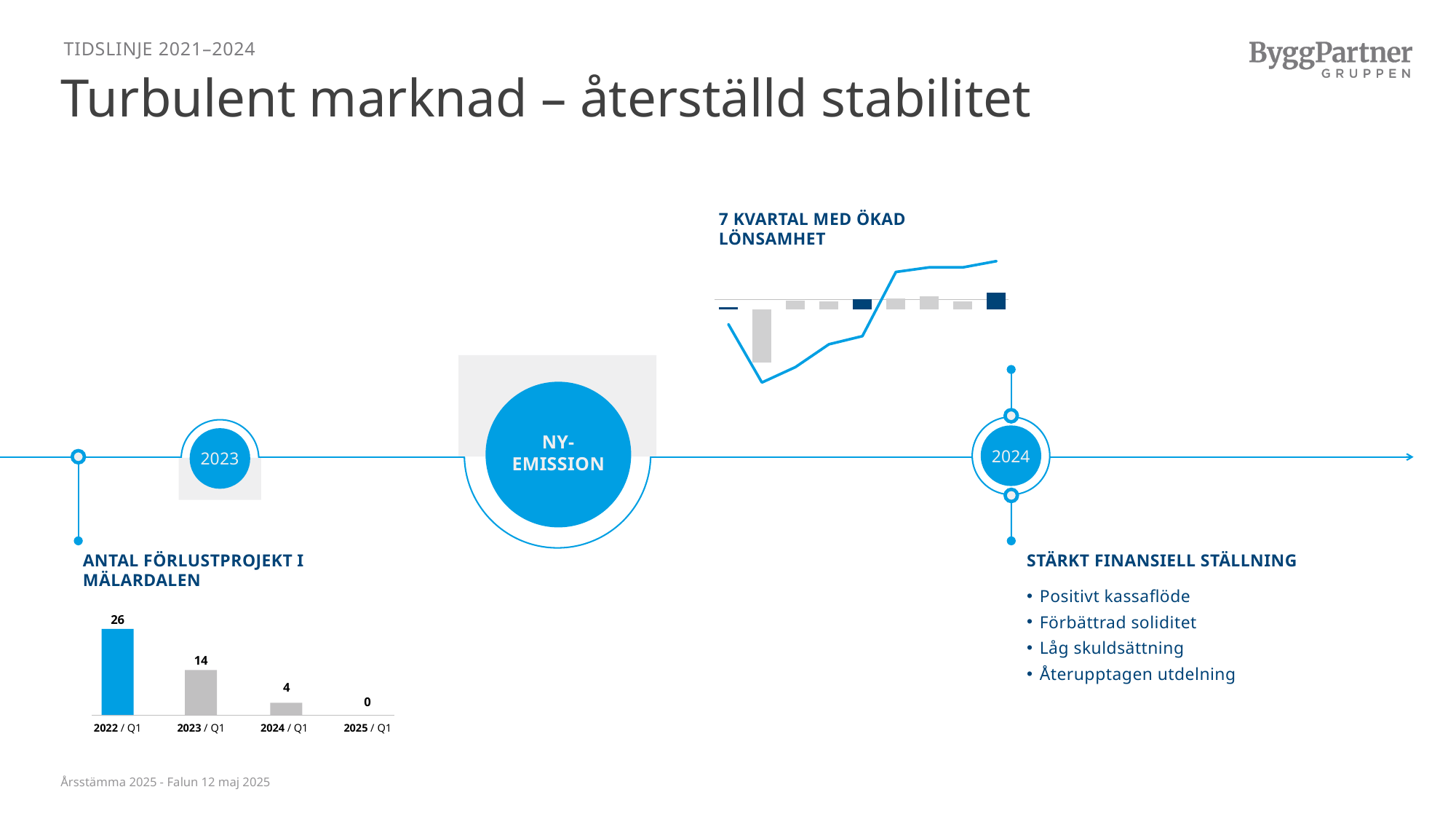
What kind of chart is 'ANTAL FÖRLUSTPROJEKT I MÄLARDALEN'? Bar chart In the chart '7 KVARTAL MED ÖKAD LÖNSAMHET', does the line rise or fall overall from left to right? Rise In the chart 'ANTAL FÖRLUSTPROJEKT I MÄLARDALEN', what is the value for 2024 / Q1? 4 In the chart 'ANTAL FÖRLUSTPROJEKT I MÄLARDALEN', which is larger, the value for 2023 / Q1 or 2024 / Q1? 2023 / Q1 How many periods are shown in the chart 'ANTAL FÖRLUSTPROJEKT I MÄLARDALEN'? 4 In the chart 'ANTAL FÖRLUSTPROJEKT I MÄLARDALEN', what is the value for 2022 / Q1? 26 In the chart 'ANTAL FÖRLUSTPROJEKT I MÄLARDALEN', what is the value for 2023 / Q1? 14 In the chart 'ANTAL FÖRLUSTPROJEKT I MÄLARDALEN', which period has the highest value? 2022 / Q1 In the chart 'ANTAL FÖRLUSTPROJEKT I MÄLARDALEN', what is the value for 2025 / Q1? 0 In the chart 'ANTAL FÖRLUSTPROJEKT I MÄLARDALEN', which period has the lowest value? 2025 / Q1 In the chart 'ANTAL FÖRLUSTPROJEKT I MÄLARDALEN', do the values rise or fall from 2022 / Q1 to 2025 / Q1? Fall In the chart 'ANTAL FÖRLUSTPROJEKT I MÄLARDALEN', what is the difference between the values for 2022 / Q1 and 2023 / Q1? 12